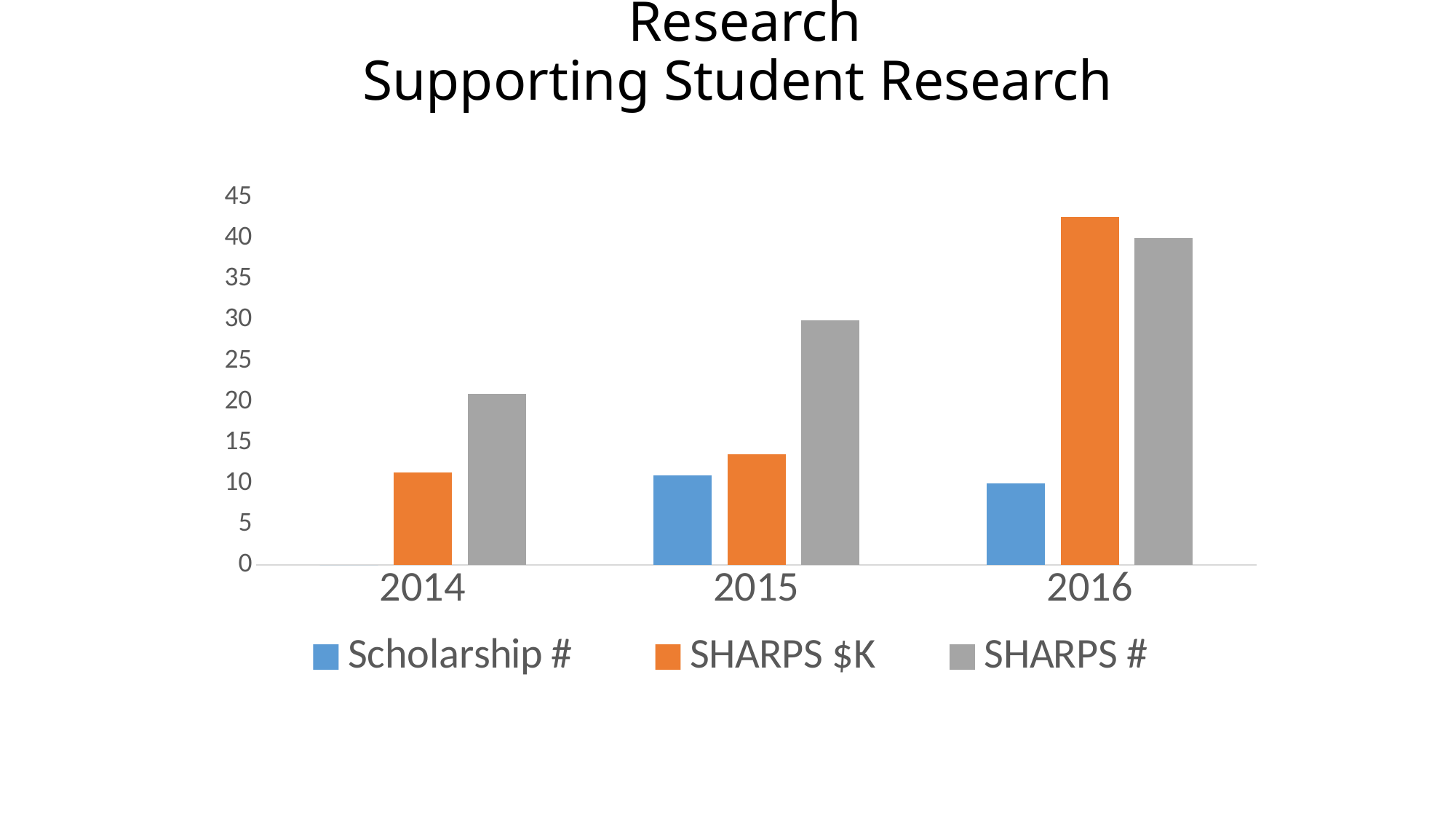
Is the value for SHARPS # in 2016 greater or less than 35? greater In 2015, which is larger: SHARPS $K or SHARPS #? SHARPS # In which year is SHARPS # highest? 2016 Which colour represents SHARPS $K in the legend? orange How many years are shown on the x axis? 3 How many series does the legend list? 3 Is the value for SHARPS # in 2015 greater or less than 25? greater What kind of chart is shown on the slide? bar chart Does SHARPS # rise or fall from 2014 to 2016? rise Is the value for SHARPS $K in 2014 greater or less than 15? less In which year is SHARPS # lowest? 2014 In which year is SHARPS $K highest? 2016